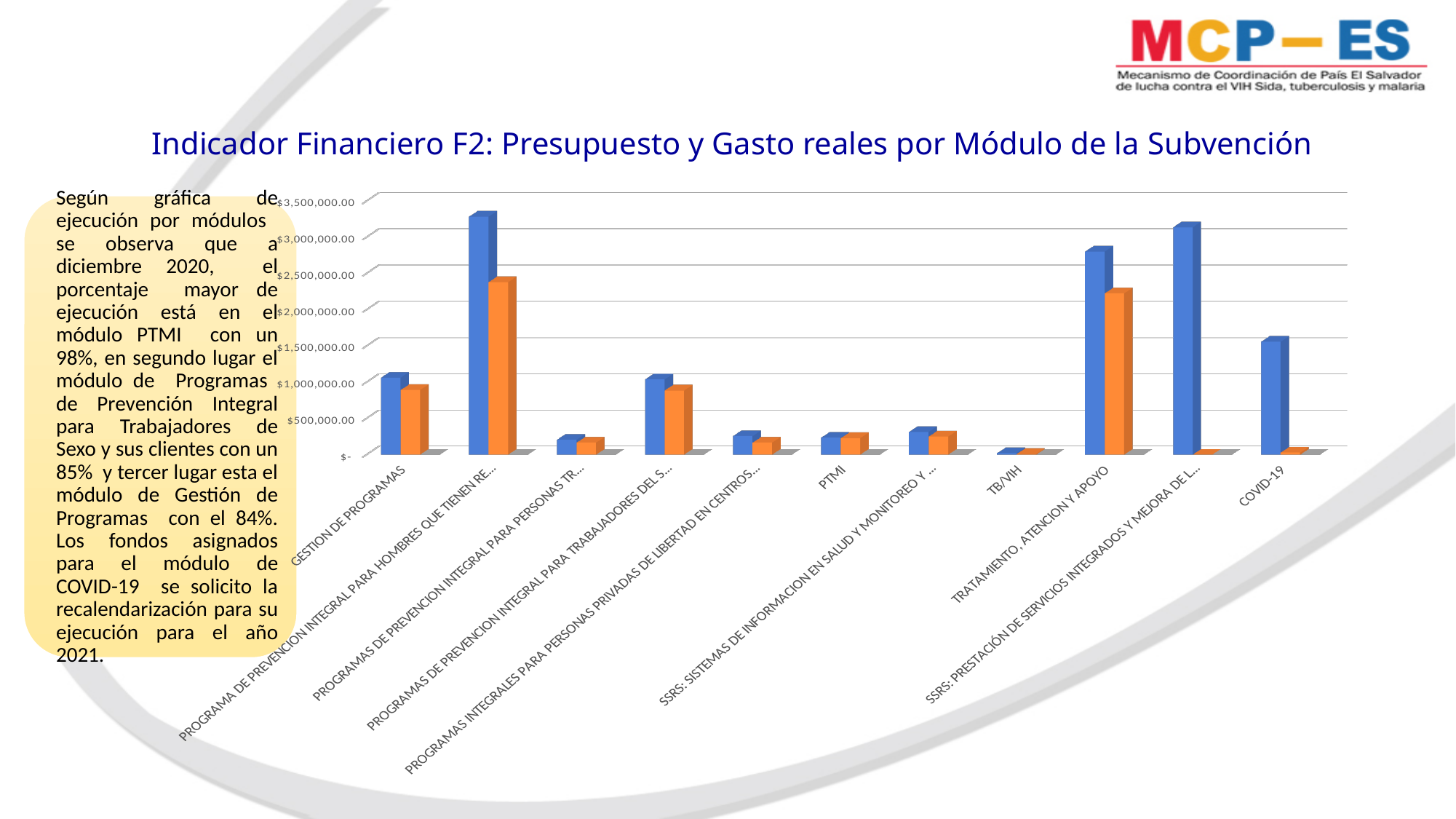
Which module has the shortest blue bar in the chart? TB/VIH Is the orange bar for COVID-19 greater or less than $500,000.00? less Which is larger: the orange bar for GESTION DE PROGRAMAS or the orange bar for COVID-19? GESTION DE PROGRAMAS Is the blue bar for PROGRAMA DE PREVENCION INTEGRAL PARA HOMBRES QUE TIENEN RE... greater or less than $3,000,000.00? greater How many categories (modules) are shown along the x axis of the chart? 11 Is the orange bar for PROGRAMA DE PREVENCION INTEGRAL PARA HOMBRES QUE TIENEN RE... greater or less than $2,000,000.00? greater How many bar colours (series) are plotted for each module in the chart? 2 Which module has the tallest blue bar in the chart? PROGRAMA DE PREVENCION INTEGRAL PARA HOMBRES QUE TIENEN RE... Which is larger: the blue bar for PROGRAMA DE PREVENCION INTEGRAL PARA HOMBRES QUE TIENEN RE... or the blue bar for TRATAMIENTO, ATENCION Y APOYO? PROGRAMA DE PREVENCION INTEGRAL PARA HOMBRES QUE TIENEN RE... What kind of chart is shown on the slide? bar chart